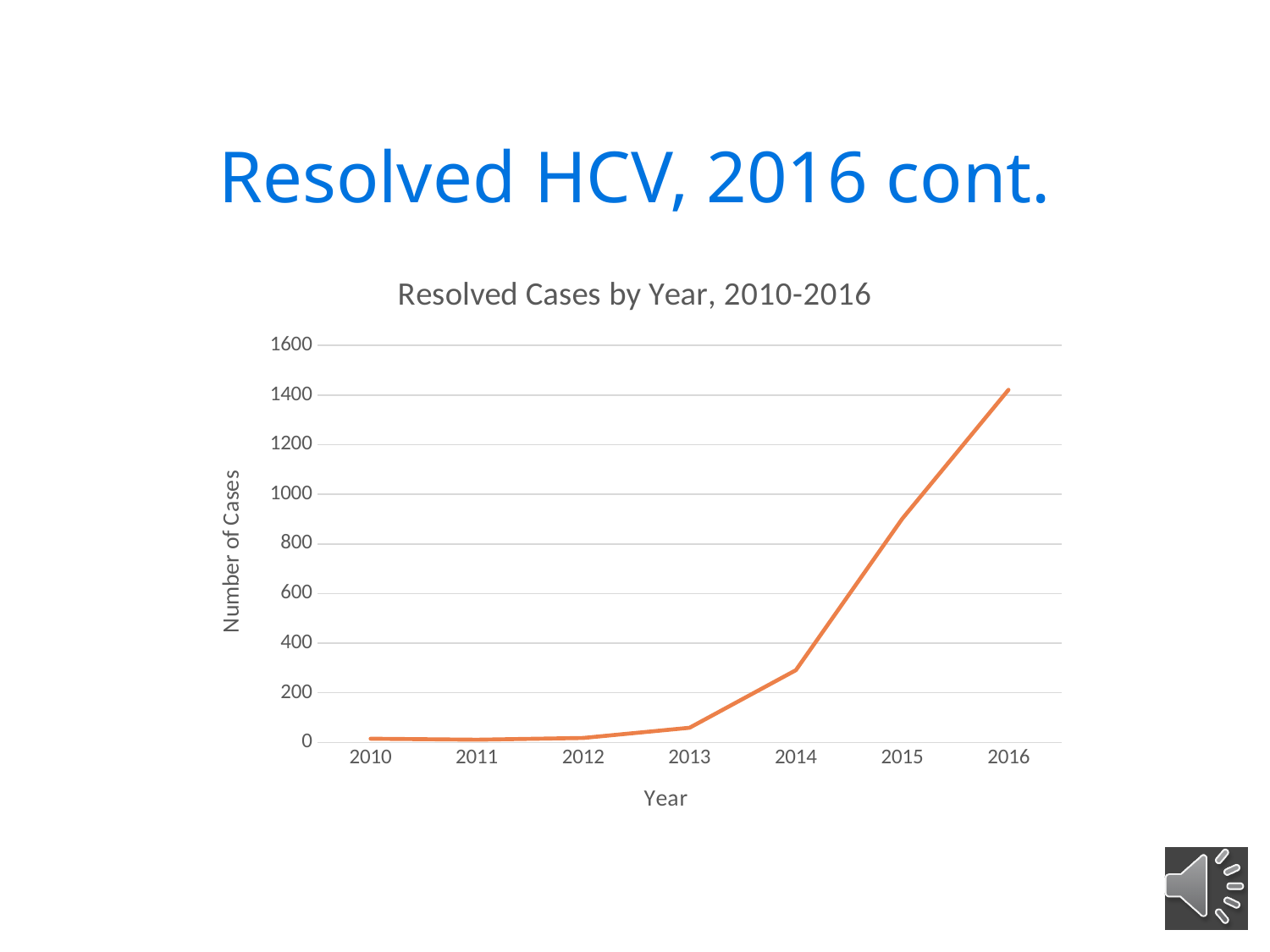
Which year has the highest number of resolved cases? 2016 Which year has more resolved cases, 2014 or 2015? 2015 Which year has more resolved cases, 2013 or 2016? 2016 Is the value for 2013 greater or less than 200? less What is the title of the chart? Resolved Cases by Year, 2010-2016 What kind of chart is shown on the slide? line chart How many years are plotted on the x axis? 7 Is the value for 2014 greater or less than 400? less What is the label of the vertical axis? Number of Cases Is the value for 2015 greater or less than 800? greater Do the number of resolved cases rise or fall from 2010 to 2016? rise